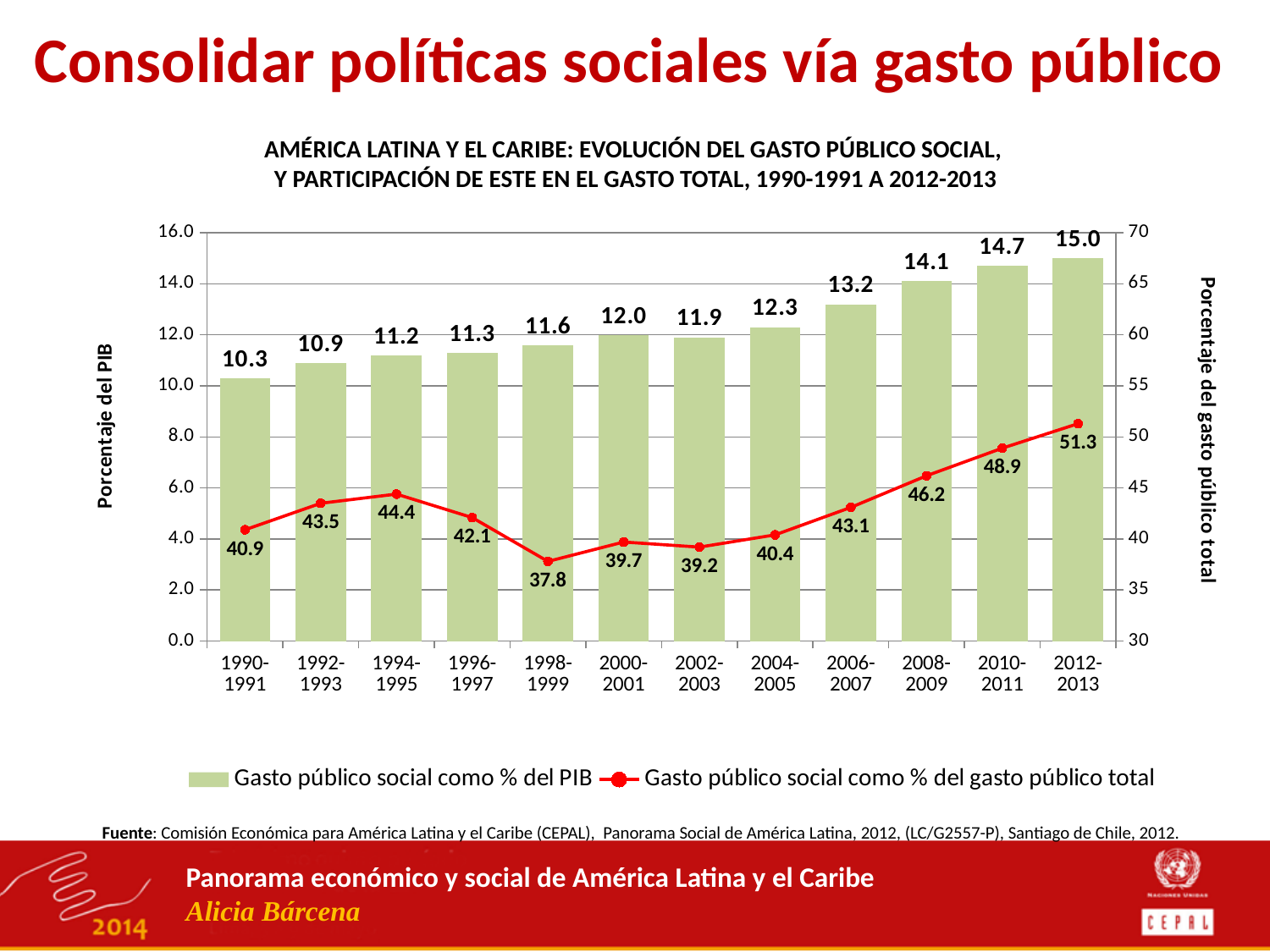
What kind of chart is used for 'Gasto público social como % del PIB'? Bar chart What is the label of the left vertical axis? Porcentaje del PIB How many periods are shown on the x axis? 12 What is the value of 'Gasto público social como % del gasto público total' for 2012-2013? 51.3 What is the value of 'Gasto público social como % del PIB' for 1990-1991? 10.3 Which period has the highest value for 'Gasto público social como % del PIB'? 2012-2013 How many series does the legend list? 2 Which is larger for 'Gasto público social como % del gasto público total': 1994-1995 or 2006-2007? 1994-1995 What is the value of 'Gasto público social como % del gasto público total' for 1998-1999? 37.8 What is the difference between the 'Gasto público social como % del PIB' values for 2012-2013 and 1990-1991? 4.7 Does 'Gasto público social como % del gasto público total' rise or fall from 2004-2005 to 2012-2013? Rise Which period has the lowest value for 'Gasto público social como % del gasto público total'? 1998-1999